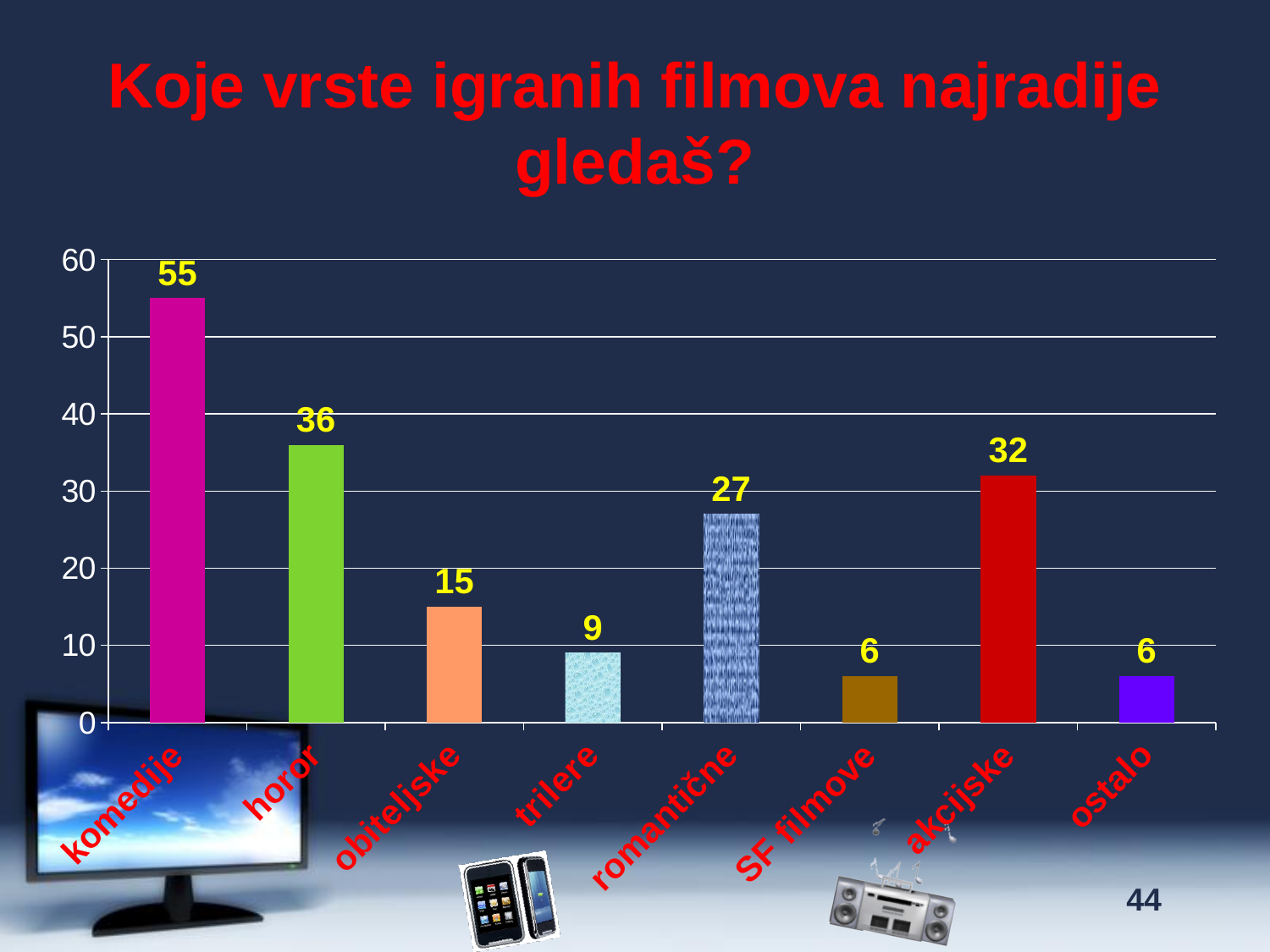
What is the title of the slide? Koje vrste igranih filmova najradije gledaš? What is the difference between the values for komedije and akcijske? 23 What is the value for komedije? 55 What colour is the bar for komedije? magenta What kind of chart is shown on the slide? bar chart Which is larger, the value for akcijske or the value for romantične? akcijske Is the value for trilere greater or less than 10? less What is the value for akcijske? 32 What is the value for romantične? 27 Which category has the highest value? komedije How many categories are shown on the x axis? 8 What is the difference between the values for horor and obiteljske? 21